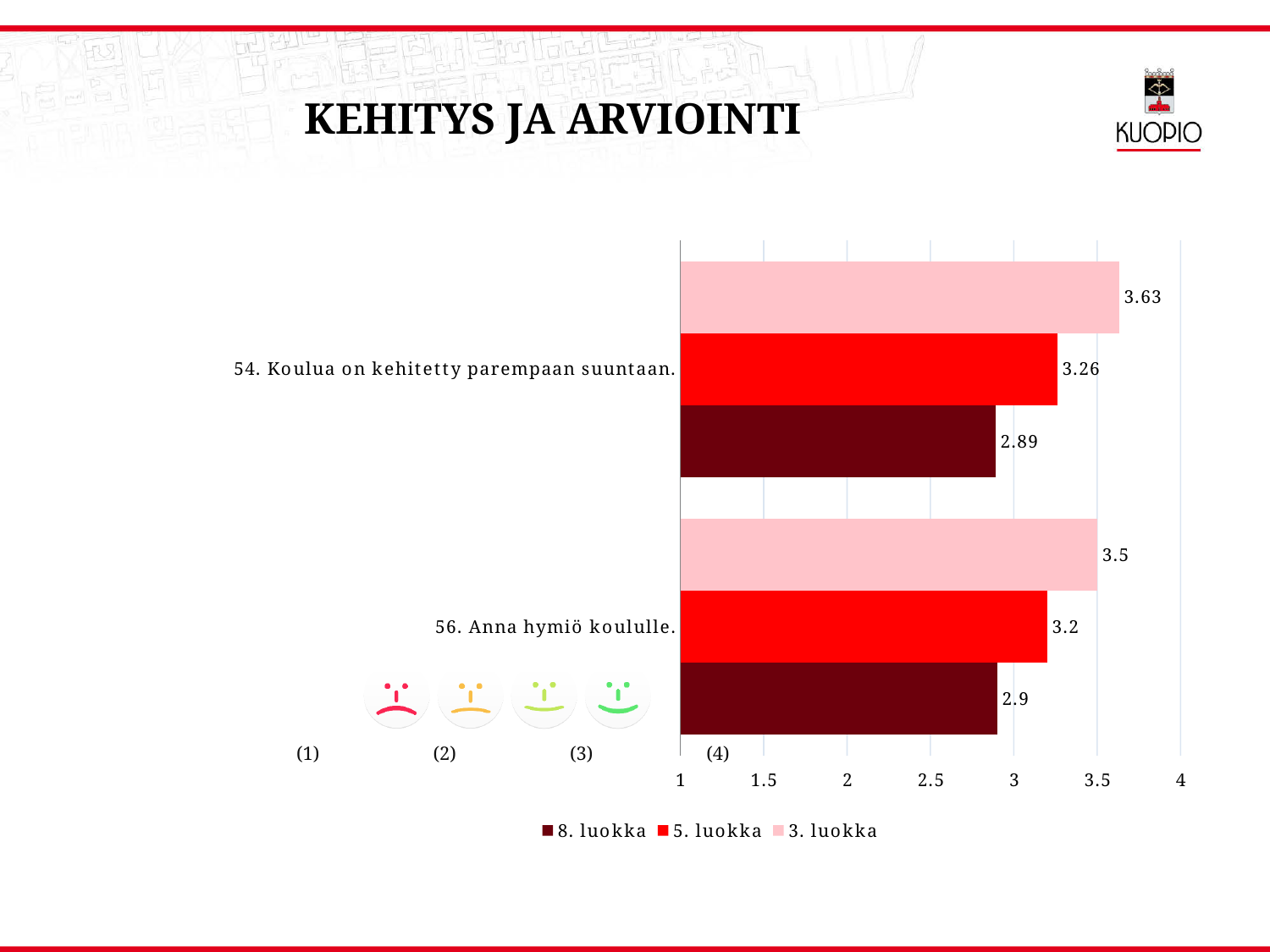
What is the value for 5. luokka on "54. Koulua on kehitetty parempaan suuntaan."? 3.26 What is the value for 3. luokka on "54. Koulua on kehitetty parempaan suuntaan."? 3.63 What kind of chart is shown on the slide? bar chart Is the 8. luokka value for "54. Koulua on kehitetty parempaan suuntaan." greater or less than 3? less Which series has the highest value for "56. Anna hymiö koululle."? 3. luokka What is the difference between the 5. luokka and 8. luokka values for "56. Anna hymiö koululle."? 0.3 Which series has the lowest value for "54. Koulua on kehitetty parempaan suuntaan."? 8. luokka What is the value for 8. luokka on "56. Anna hymiö koululle."? 2.9 What is the difference between the 3. luokka and 8. luokka values for "54. Koulua on kehitetty parempaan suuntaan."? 0.74 How many series does the legend list? 3 How many categories (questions) are shown on the chart? 2 Which is larger: the 5. luokka value for "54. Koulua on kehitetty parempaan suuntaan." or the 5. luokka value for "56. Anna hymiö koululle."? 54. Koulua on kehitetty parempaan suuntaan.